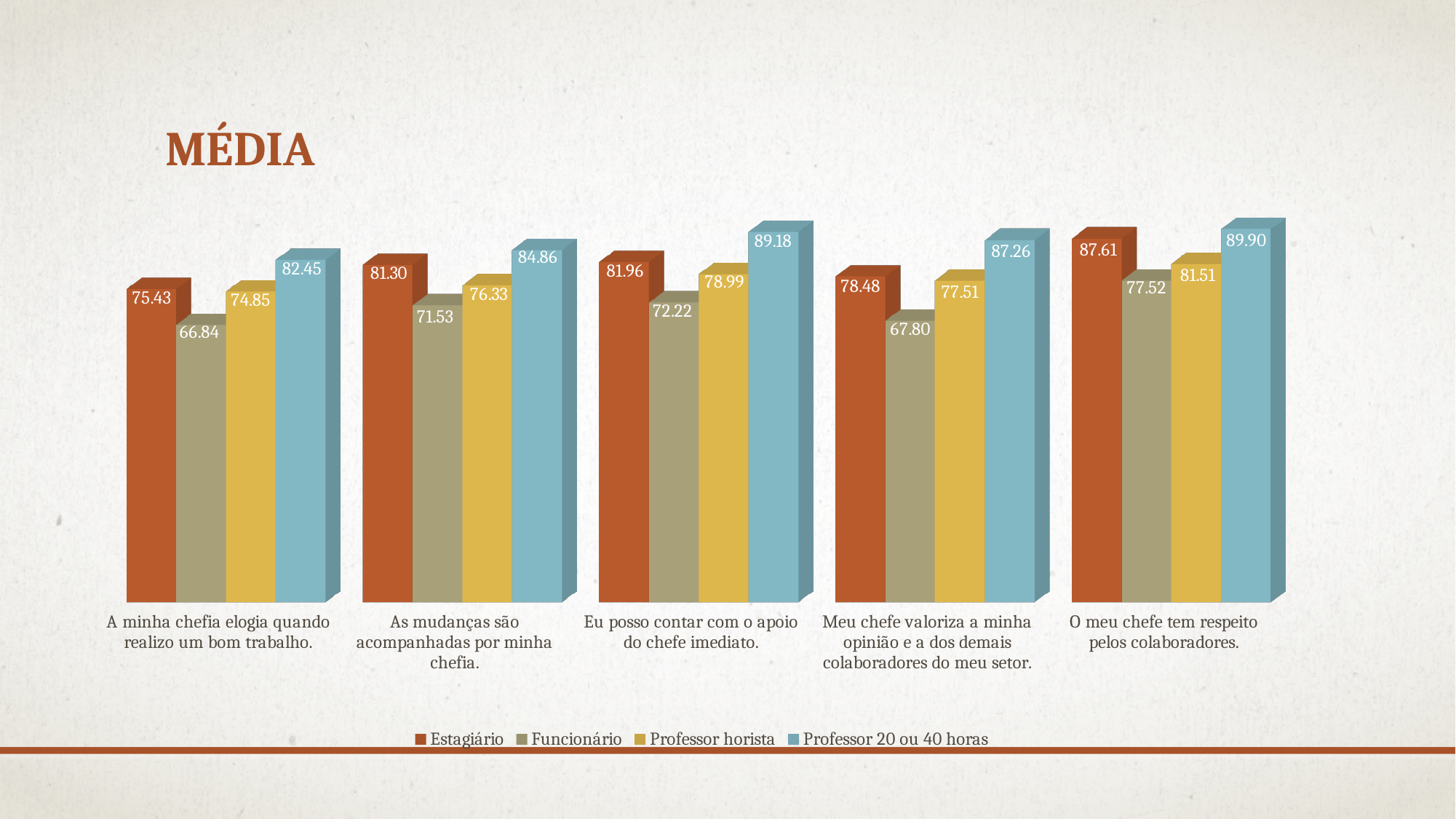
How many categories are shown on the x axis of the chart? 5 What is the value for Estagiário in the category "A minha chefia elogia quando realizo um bom trabalho."? 75.43 What kind of chart is shown on the slide? Bar chart What is the difference between the Professor 20 ou 40 horas value and the Funcionário value in the category "O meu chefe tem respeito pelos colaboradores."? 12.38 In the category "O meu chefe tem respeito pelos colaboradores.", which is larger: the Estagiário value or the Professor horista value? Estagiário In which category does the Funcionário series have its lowest value? A minha chefia elogia quando realizo um bom trabalho. What is the difference between the Professor 20 ou 40 horas value and the Estagiário value in the category "A minha chefia elogia quando realizo um bom trabalho."? 7.02 What is the value for Funcionário in the category "Meu chefe valoriza a minha opinião e a dos demais colaboradores do meu setor."? 67.80 How many series does the legend list? 4 What is the value for Professor 20 ou 40 horas in the category "Eu posso contar com o apoio do chefe imediato."? 89.18 In which category does the Professor 20 ou 40 horas series reach its highest value? O meu chefe tem respeito pelos colaboradores. What is the value for Professor horista in the category "As mudanças são acompanhadas por minha chefia."? 76.33